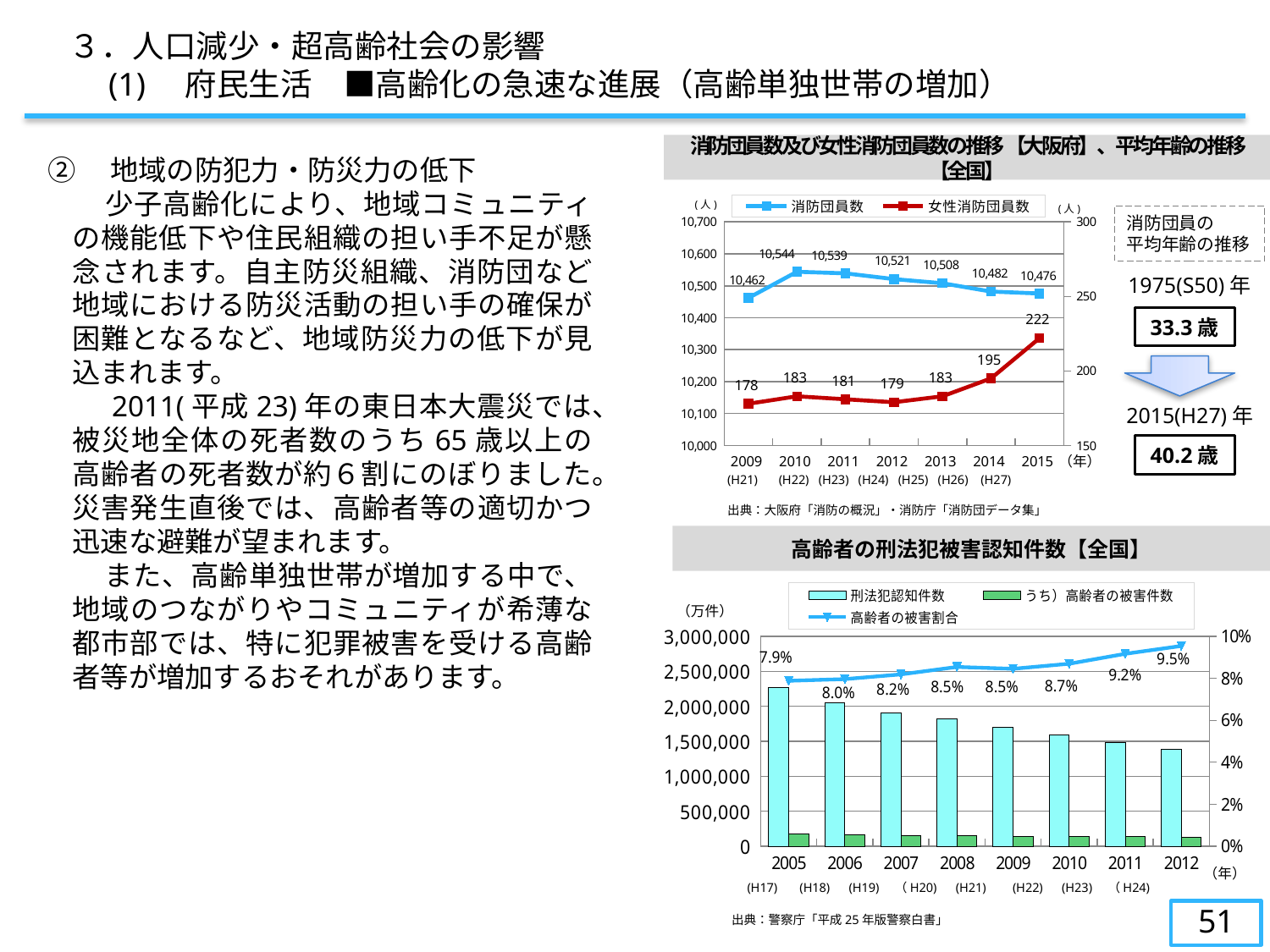
In the top chart (消防団員数及び女性消防団員数の推移), what is the value of 消防団員数 in 2010? 10,544 In the bottom chart (高齢者の刑法犯被害認知件数【全国】), what is the difference in 高齢者の被害割合 between 2011 and 2012? 0.3% In the bottom chart (高齢者の刑法犯被害認知件数【全国】), how many years are shown on the x axis? 8 In the top chart (消防団員数及び女性消防団員数の推移), how many series does the legend list? 2 In the bottom chart (高齢者の刑法犯被害認知件数【全国】), is the value of 刑法犯認知件数 in 2005 greater or less than 2,000,000? greater In the bottom chart (高齢者の刑法犯被害認知件数【全国】), which year has the lowest 高齢者の被害割合? 2005 In the top chart (消防団員数及び女性消防団員数の推移), what type of chart is it? line chart In the top chart (消防団員数及び女性消防団員数の推移), does 女性消防団員数 rise or fall from 2013 to 2015? rise In the bottom chart (高齢者の刑法犯被害認知件数【全国】), what is the 高齢者の被害割合 in 2012? 9.5% In the top chart (消防団員数及び女性消防団員数の推移), which year has the lowest 消防団員数? 2009 In the top chart (消防団員数及び女性消防団員数の推移), what is the value of 女性消防団員数 in 2015? 222 In the top chart (消防団員数及び女性消防団員数の推移), what is the difference in 消防団員数 between 2010 and 2015? 68